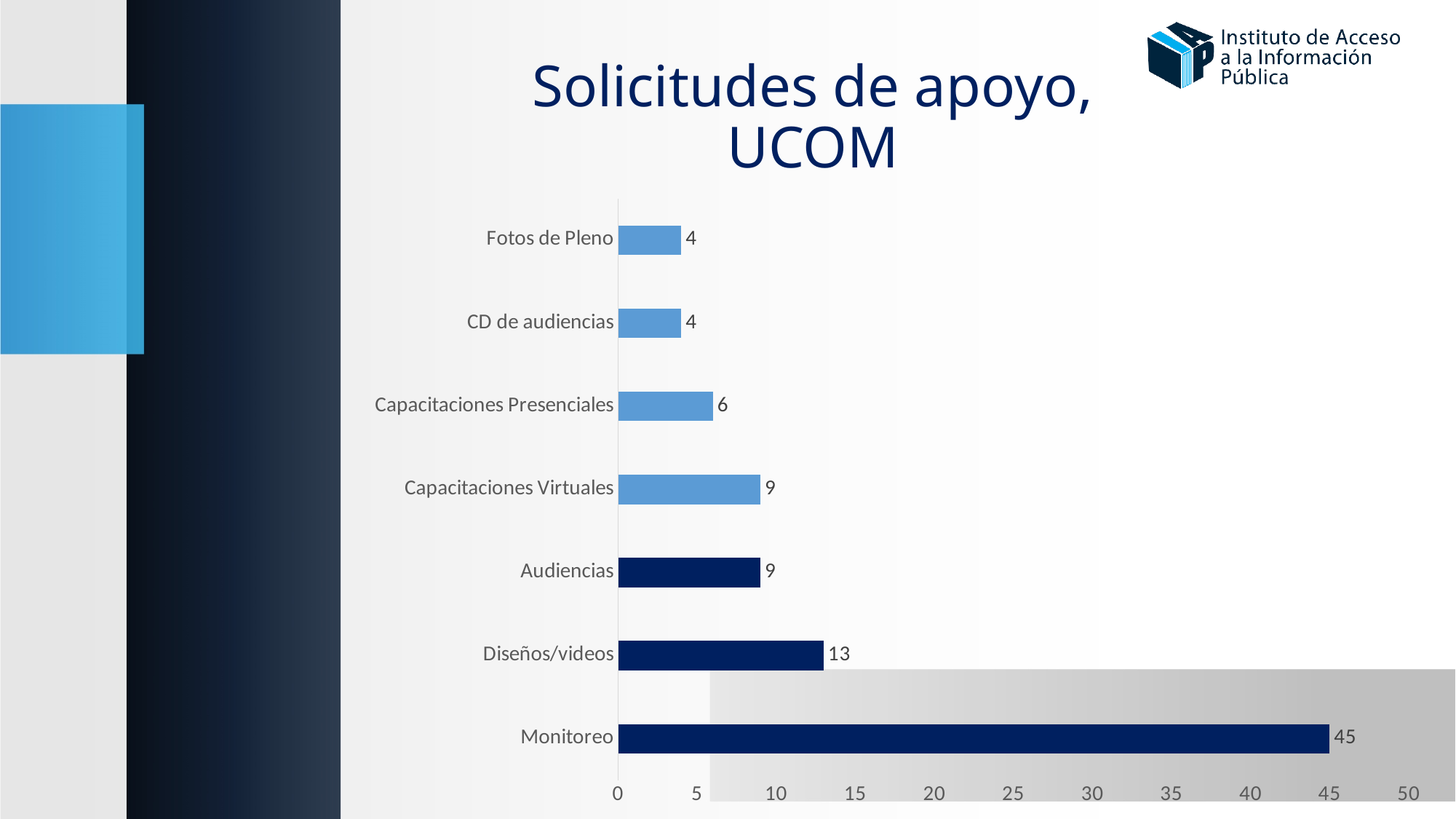
What is the difference between the values for Monitoreo and Diseños/videos? 32 Which is larger, the value for Diseños/videos or the value for Audiencias? Diseños/videos What is the value for Monitoreo? 45 How many categories are shown in the chart? 7 What is the value for Capacitaciones Presenciales? 6 What kind of chart is shown on the slide? Bar chart What is the difference between the values for Capacitaciones Virtuales and Capacitaciones Presenciales? 3 What is the value for Fotos de Pleno? 4 Which category has the highest value? Monitoreo What is the title of the slide? Solicitudes de apoyo, UCOM What is the value for Diseños/videos? 13 Is the value for Monitoreo greater or less than 40? greater